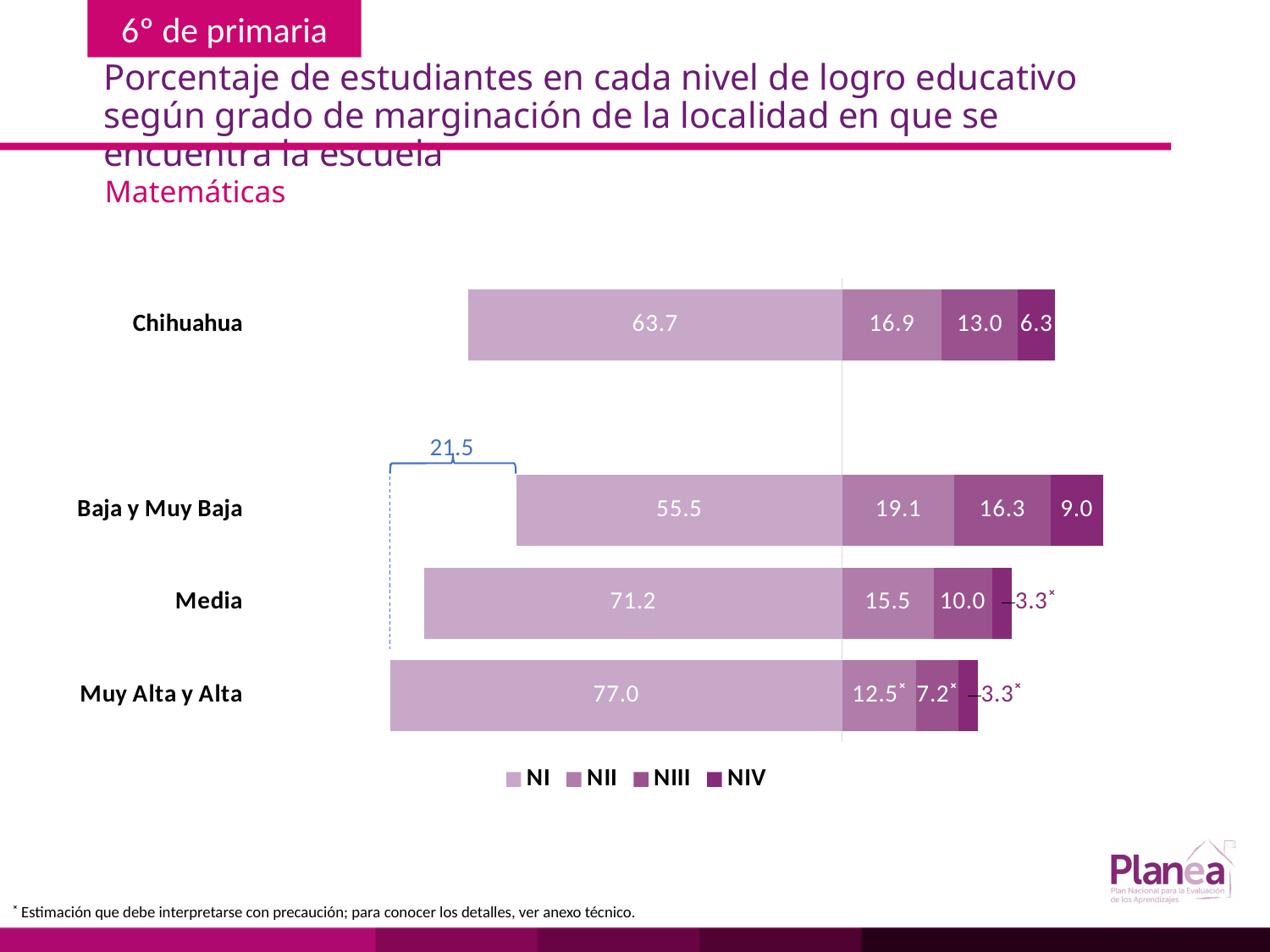
Which is larger, the NII value for Chihuahua or the NII value for Baja y Muy Baja? Baja y Muy Baja What is the total of the stacked bar for Chihuahua? 99.9 What kind of chart is shown on the slide? Stacked bar chart What is the NI value for Chihuahua? 63.7 What is the NIII value for Muy Alta y Alta? 7.2 How many categories are shown on the chart? 4 Which category has the highest NI value? Muy Alta y Alta Which category has the lowest NI value? Baja y Muy Baja How many series does the legend list? 4 What is the difference between the NI values for Muy Alta y Alta and Baja y Muy Baja? 21.5 What is the NIV value for Baja y Muy Baja? 9.0 What is the NII value for Media? 15.5